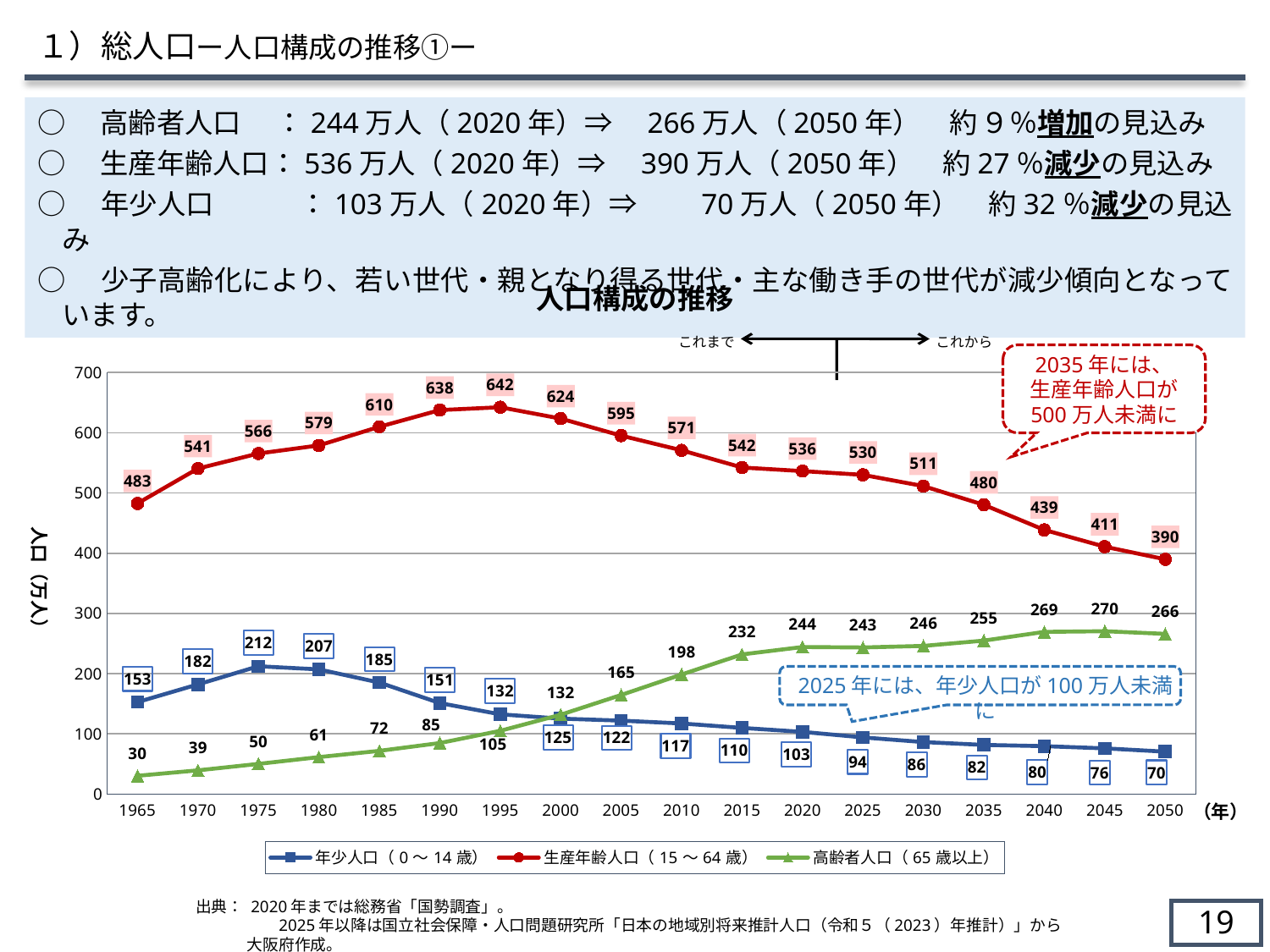
How many years (data points) are plotted on the x axis? 18 How many series does the legend list? 3 In which year does 生産年齢人口 reach its highest value? 1995 What type of chart is shown on the slide? line chart In which year is 年少人口 at its lowest value? 2050 What is the value of 高齢者人口 in 2020? 244 What is the value of 生産年齢人口 in 1995? 642 What is the difference between 生産年齢人口 in 2020 and in 2050? 146 What is the title of the chart? 人口構成の推移 What is the value of 年少人口 in 1975? 212 Does 高齢者人口 generally rise or fall from 1965 to 2045? rise Which is larger in 2000: 年少人口 or 高齢者人口? 高齢者人口